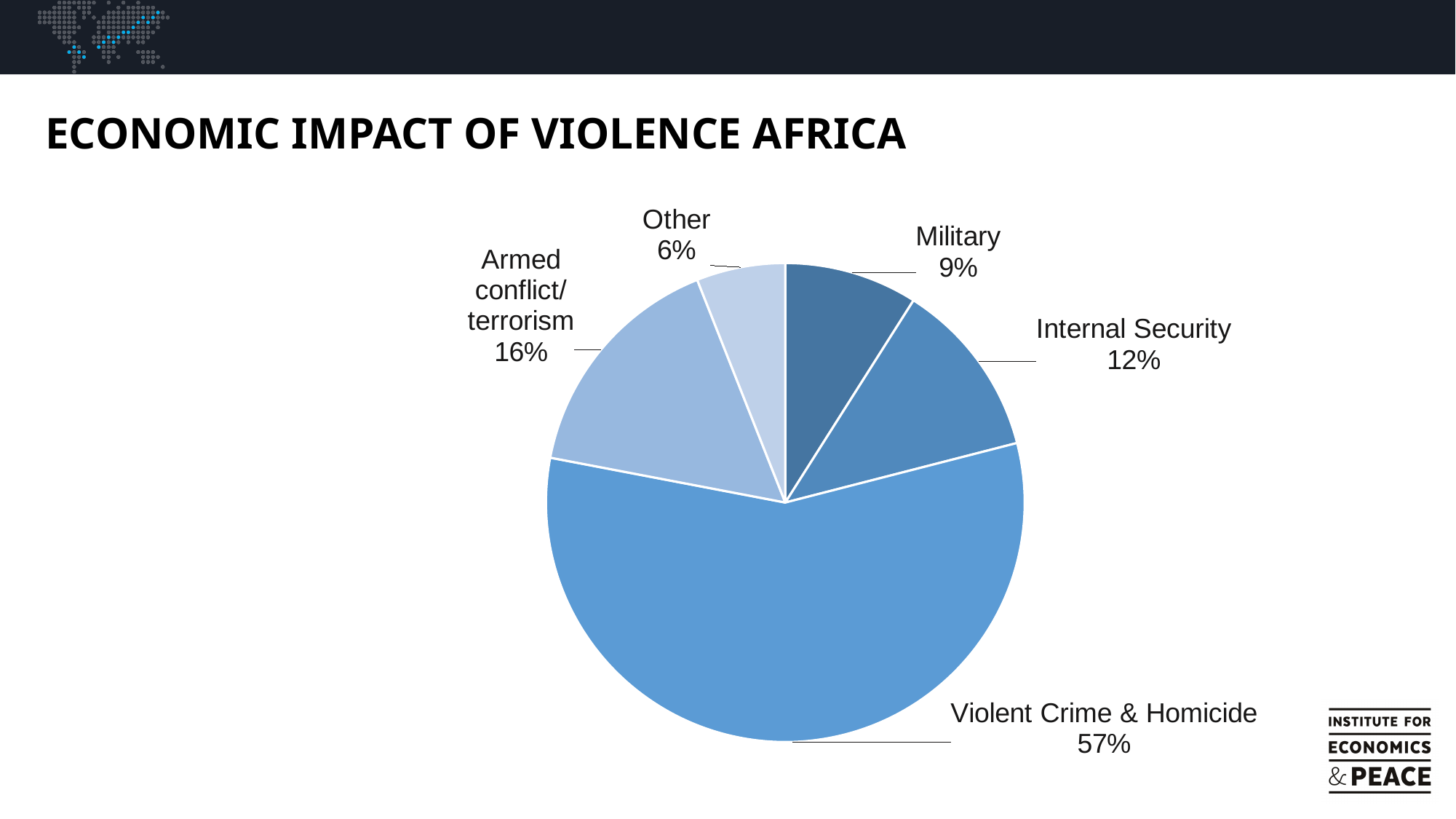
What is the difference in percentage points between Armed conflict/terrorism and Internal Security? 4 What share of the pie does Violent Crime & Homicide account for? 57% What is the value shown for Armed conflict/terrorism? 16% What kind of chart is shown on the slide? pie chart What is the value shown for Internal Security? 12% What is the value shown for Military? 9% What is the value shown for Other? 6% Which category has the largest slice of the pie? Violent Crime & Homicide Which category has the smallest slice of the pie? Other What is the title of the slide containing the chart? ECONOMIC IMPACT OF VIOLENCE AFRICA Which is larger, Military or Internal Security? Internal Security How many slices does the pie chart have? 5